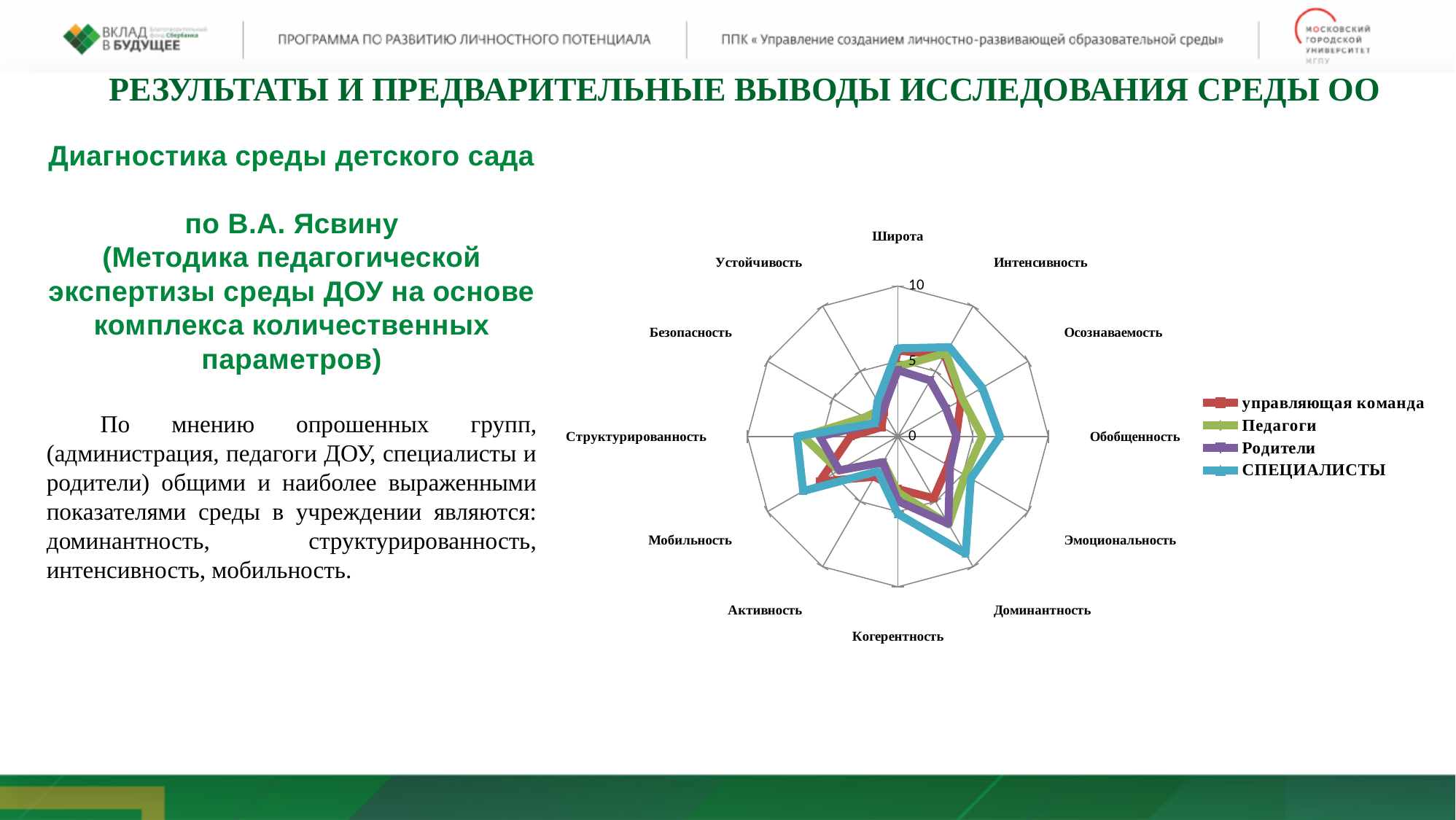
Is the value for управляющая команда on Структурированность greater or less than 5? less What is the maximum value shown on the radial axis of the chart? 10 Is the value for СПЕЦИАЛИСТЫ on Обобщенность greater or less than 5? greater Which series are listed in the legend of the radar chart? управляющая команда, Педагоги, Родители, СПЕЦИАЛИСТЫ How many series does the legend of the radar chart list? 4 On Доминантность, which series has the larger value: СПЕЦИАЛИСТЫ or управляющая команда? СПЕЦИАЛИСТЫ What kind of chart is shown on the slide? Radar chart How many categories (axes) does the radar chart have? 12 Is the value for СПЕЦИАЛИСТЫ on Структурированность greater or less than 5? greater Which series has the lowest value on Структурированность? управляющая команда Which series has the highest value on Доминантность? СПЕЦИАЛИСТЫ